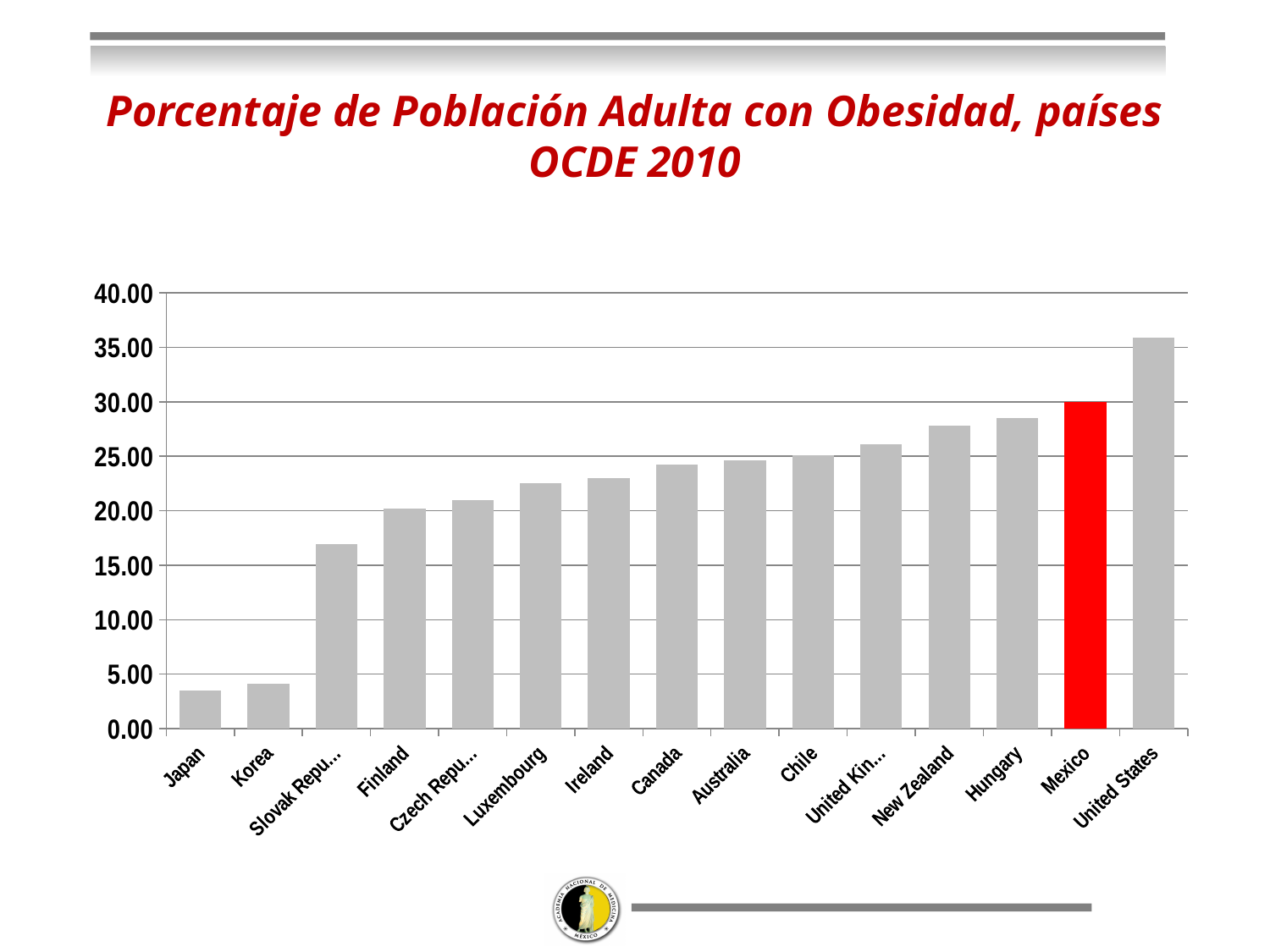
Do the values generally rise or fall from left to right along the x axis? rise Is the value for Luxembourg greater or less than 20.00? greater Which country has the highest percentage of adult obesity in the chart? United States Is the value for Slovak Republic greater or less than 20.00? less What kind of chart is shown on the slide? bar chart Which country's bar is highlighted in red? Mexico How many countries are shown on the x axis of the chart? 15 Which country has the lowest percentage of adult obesity in the chart? Japan Is the value for Japan greater or less than 5.00? less Which has a higher value, Hungary or Canada? Hungary Which has a higher value, Mexico or Hungary? Mexico